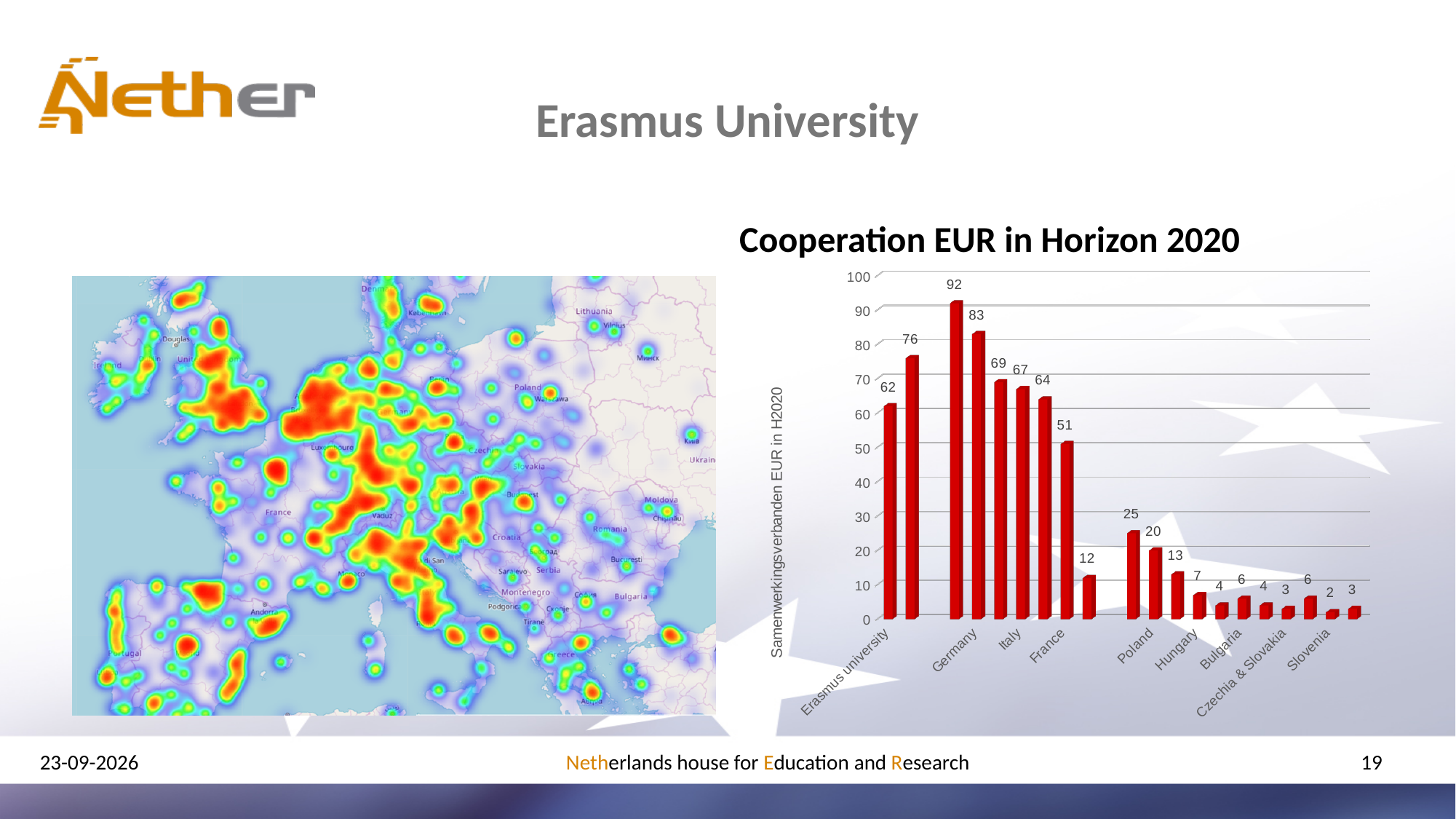
What is the difference between the highest value (92) and the lowest value (2) in the chart? 90 What is the title of the chart on the slide? Cooperation EUR in Horizon 2020 What kind of chart is shown on the slide? bar chart What is the label on the vertical axis of the chart? Samenwerkingsverbanden EUR in H2020 Which is larger, the value for Erasmus university or the highest value in the chart? the highest value (92) Do the values in the chart generally rise or fall from left to right? fall What is the highest value shown in the chart? 92 What is the value for Erasmus university in the chart? 62 Is the value for Erasmus university greater or less than 60? greater What is the lowest value shown in the chart? 2 How many bars are plotted in the chart? 20 What is the difference between the two tallest bars in the chart (92 and 83)? 9